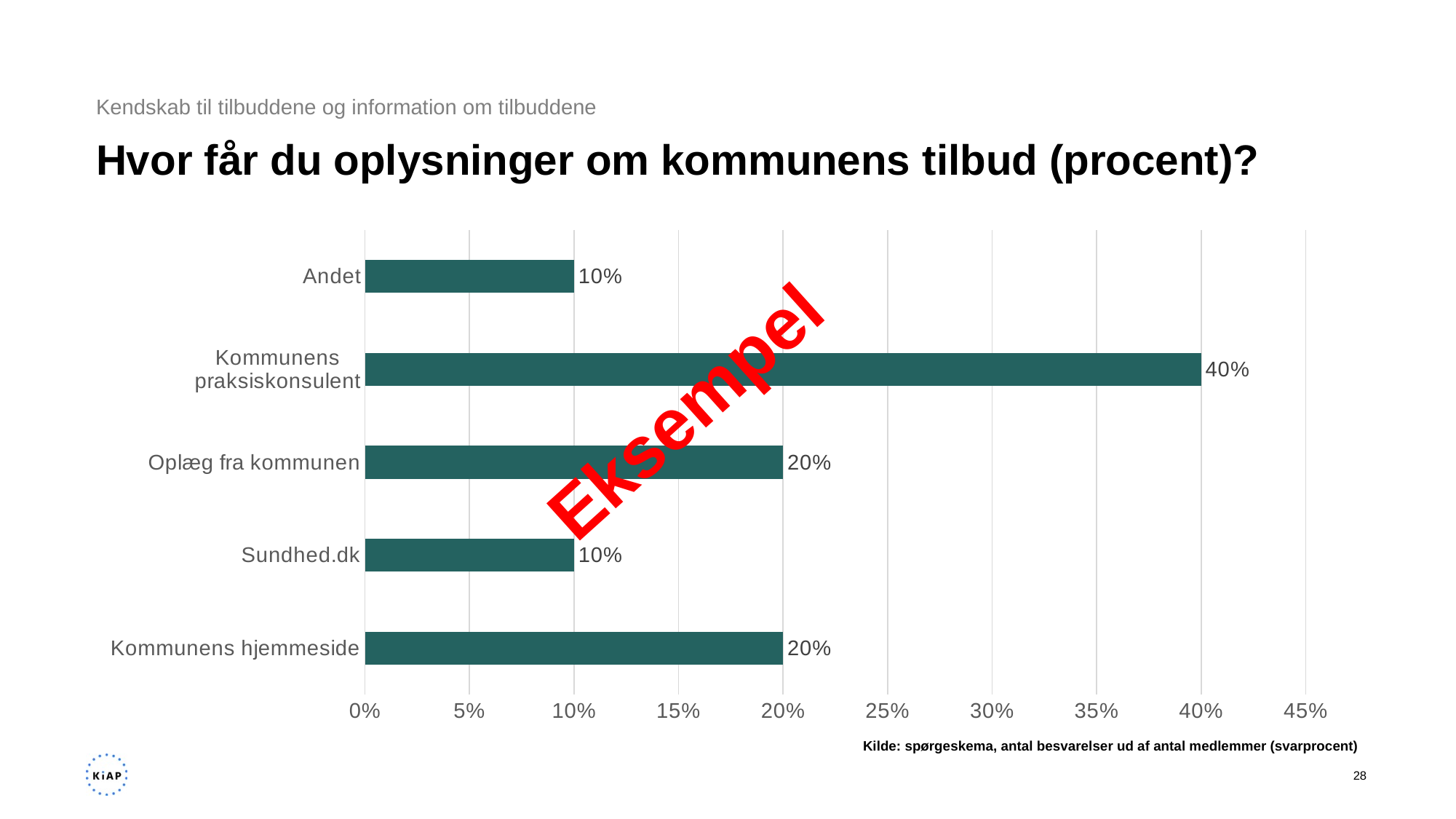
What is the value for Andet? 10% Which is larger, the value for Oplæg fra kommunen or the value for Andet? Oplæg fra kommunen What is the title of the chart? Hvor får du oplysninger om kommunens tilbud (procent)? What is the value for Kommunens praksiskonsulent? 40% What is the difference between Kommunens hjemmeside and Sundhed.dk? 10% How many categories are shown in the chart? 5 What is the value for Sundhed.dk? 10% What is the difference between Kommunens praksiskonsulent and Oplæg fra kommunen? 20% What is the value for Kommunens hjemmeside? 20% What kind of chart is shown on the slide? Bar chart Which category has the highest value? Kommunens praksiskonsulent Is the value for Kommunens praksiskonsulent greater or less than 30%? greater